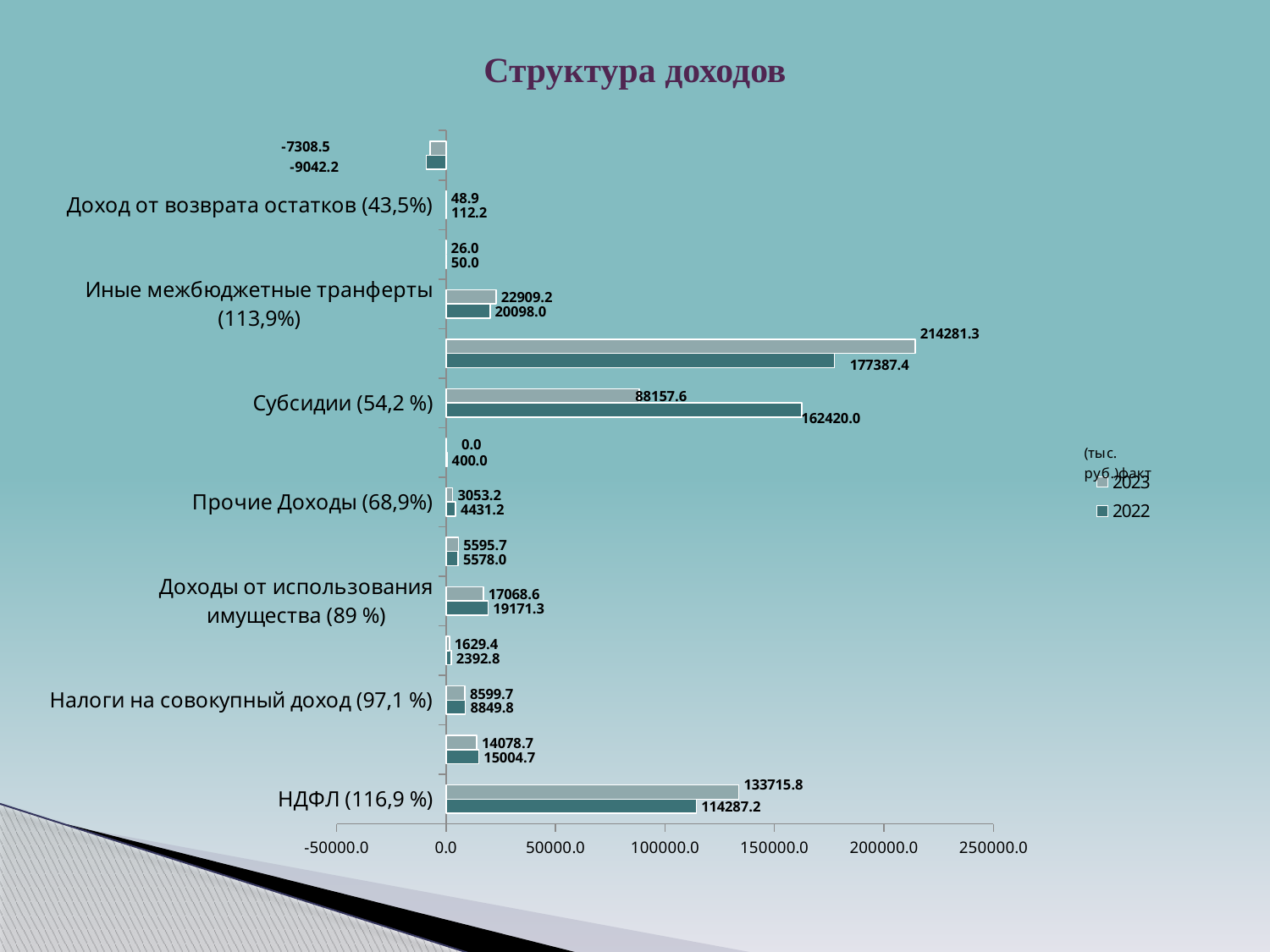
What is the 2023 value for Иные межбюджетные трансферты (113,9%)? 22909.2 What is the difference between the 2023 and 2022 values for Налоги на совокупный доход (97,1 %)? 250.1 What is the 2022 value for Субсидии (54,2 %)? 162420.0 What is the 2022 value for Доходы от использования имущества (89 %)? 19171.3 Is the 2023 value for НДФЛ (116,9 %) greater or less than 100000.0? greater What type of chart is shown on the slide? bar chart What is the 2023 value for НДФЛ (116,9 %)? 133715.8 For Прочие Доходы (68,9%), which year has the larger value, 2022 or 2023? 2022 What is the 2022 value for НДФЛ (116,9 %)? 114287.2 How many series does the legend list? 2 What is the title of the chart? Структура доходов What is the difference between the 2022 and 2023 values for Субсидии (54,2 %)? 74262.4